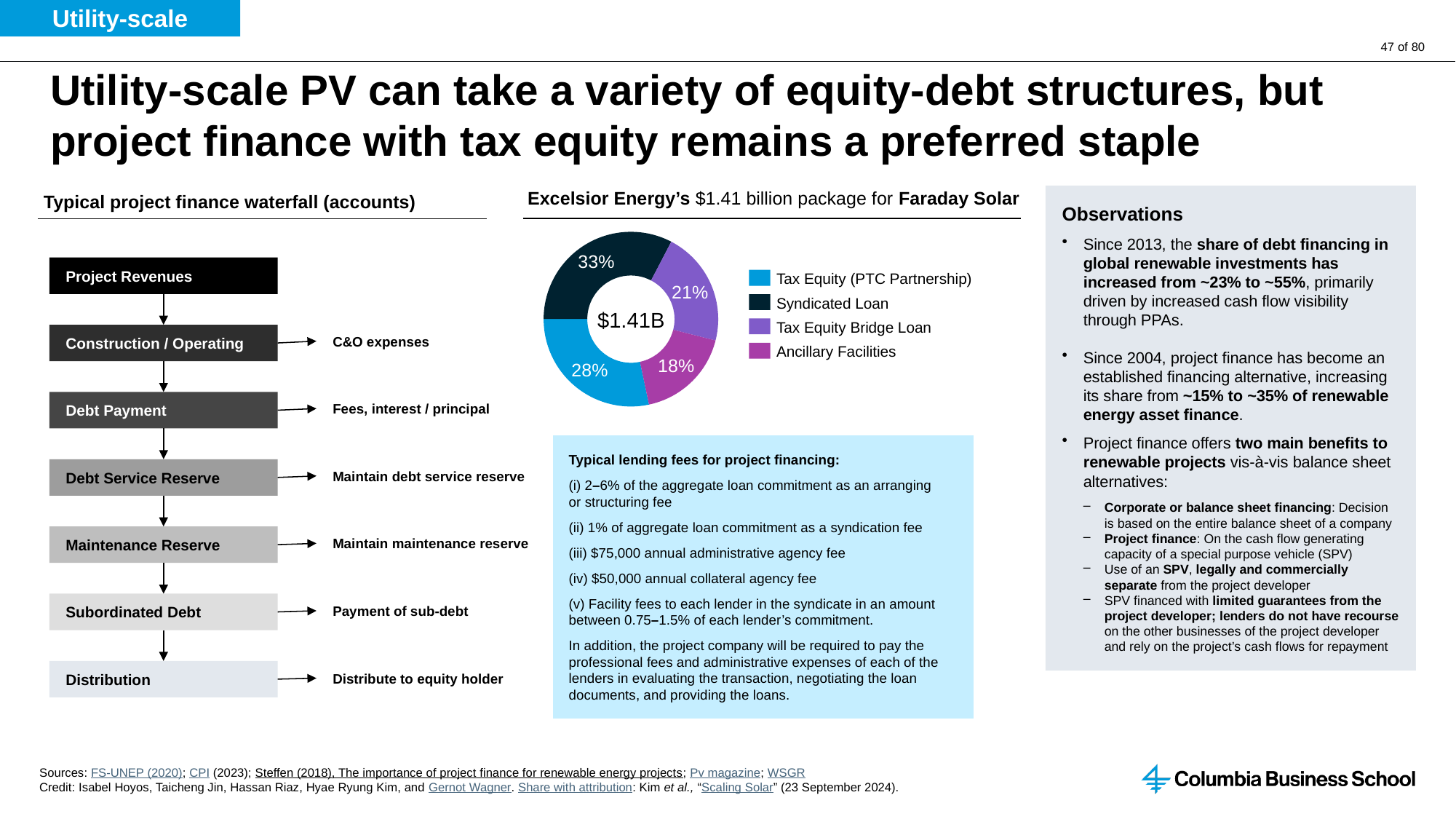
In the Faraday Solar package chart, what share is Tax Equity (PTC Partnership)? 28% In the Faraday Solar package chart, what share is Ancillary Facilities? 18% In the Faraday Solar package chart, what share is the Tax Equity Bridge Loan? 21% Which component has the smallest share of the Faraday Solar package? Ancillary Facilities Which component has the largest share of the Faraday Solar package? Syndicated Loan How many components does the legend of the Faraday Solar package chart list? 4 In the Faraday Solar package chart, what colour represents the Syndicated Loan? Dark navy In the Faraday Solar package chart, what share is the Syndicated Loan? 33% In the Faraday Solar package chart, which is larger: Tax Equity (PTC Partnership) or Tax Equity Bridge Loan? Tax Equity (PTC Partnership) In the Faraday Solar package chart, how many percentage points larger is the Syndicated Loan share than the Ancillary Facilities share? 15 percentage points What kind of chart is used to show Excelsior Energy's $1.41 billion package for Faraday Solar? Pie chart (donut) What value is printed in the center of the Faraday Solar package donut chart? $1.41B